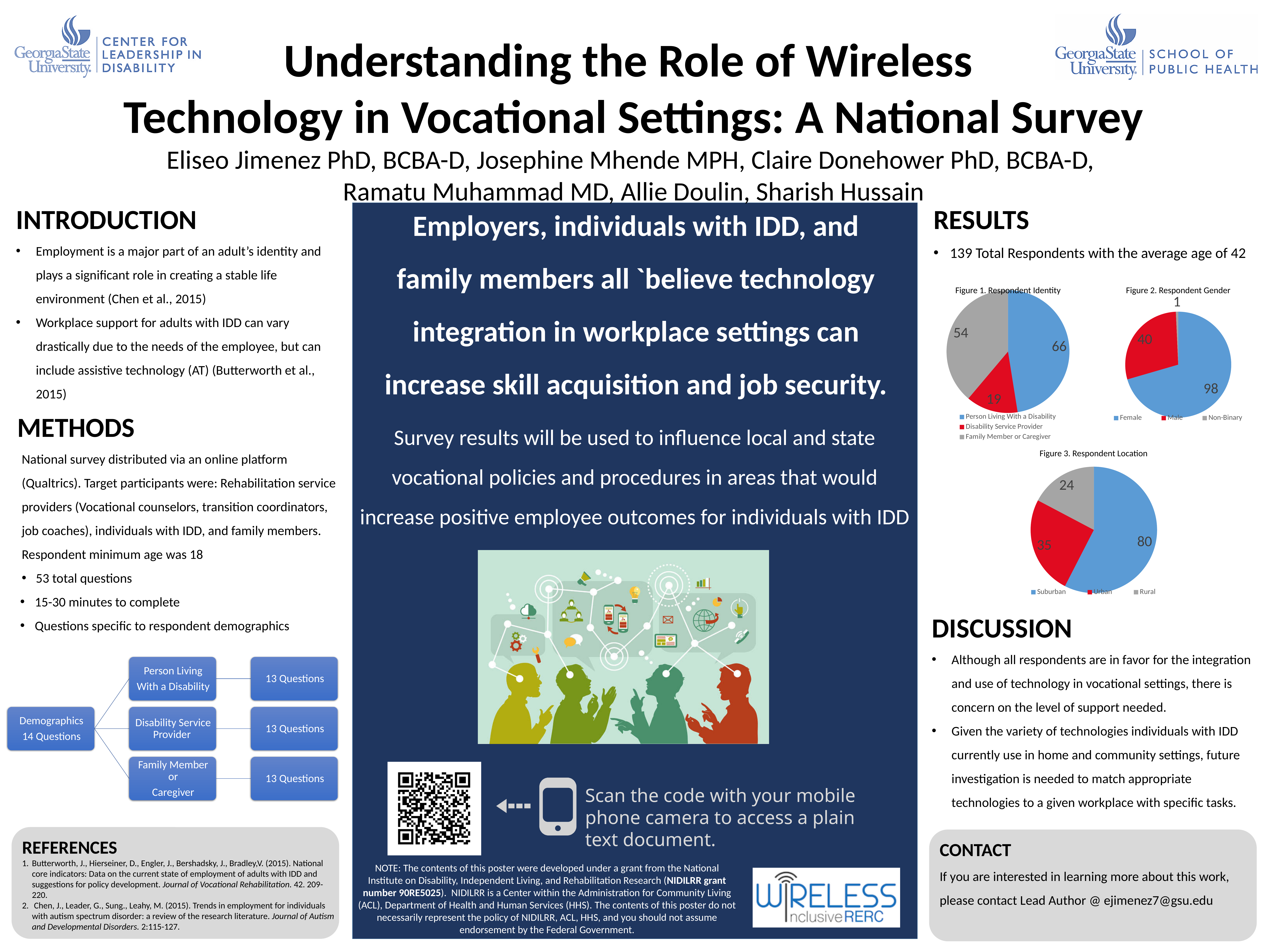
In Figure 2. Respondent Gender, how many categories does the legend list? 3 In Figure 1. Respondent Identity, how many respondents are Person Living With a Disability? 66 In Figure 1. Respondent Identity, what colour is the Family Member or Caregiver slice? Gray In Figure 2. Respondent Gender, which category is the largest? Female In Figure 2. Respondent Gender, how many respondents are Male? 40 In Figure 1. Respondent Identity, which category has the fewest respondents? Disability Service Provider In Figure 3. Respondent Location, what is the difference between Suburban and Urban? 45 In Figure 1. Respondent Identity, what is the total number of respondents across all three categories? 139 In Figure 3. Respondent Location, how many respondents are Rural? 24 In Figure 3. Respondent Location, which is larger, Urban or Rural? Urban What type of chart is Figure 3. Respondent Location? Pie chart In Figure 1. Respondent Identity, what is the difference between Person Living With a Disability and Family Member or Caregiver? 12